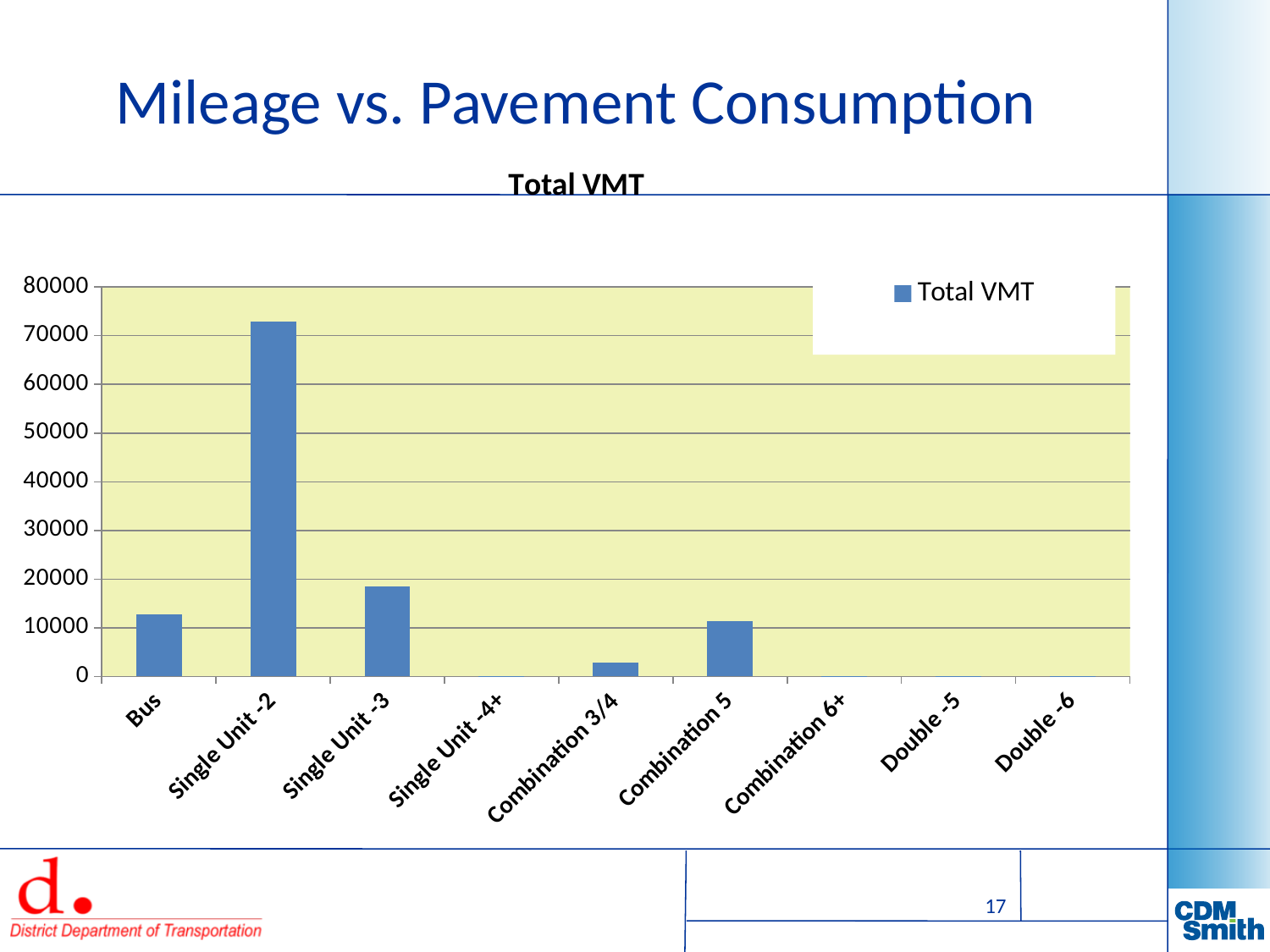
Is the Total VMT for Single Unit -3 greater or less than 10000? greater Which has a higher Total VMT, Single Unit -3 or Combination 5? Single Unit -3 Which has a higher Total VMT, Bus or Combination 3/4? Bus Is the Total VMT for Single Unit -2 greater or less than 70000? greater What is the title of the chart? Total VMT How many series does the chart legend list? 1 What kind of chart is shown on the slide? bar chart Is the Total VMT for Combination 3/4 greater or less than 10000? less How many categories are shown on the x axis of the chart? 9 What is the name of the series shown in the chart legend? Total VMT Which category has the highest Total VMT? Single Unit -2